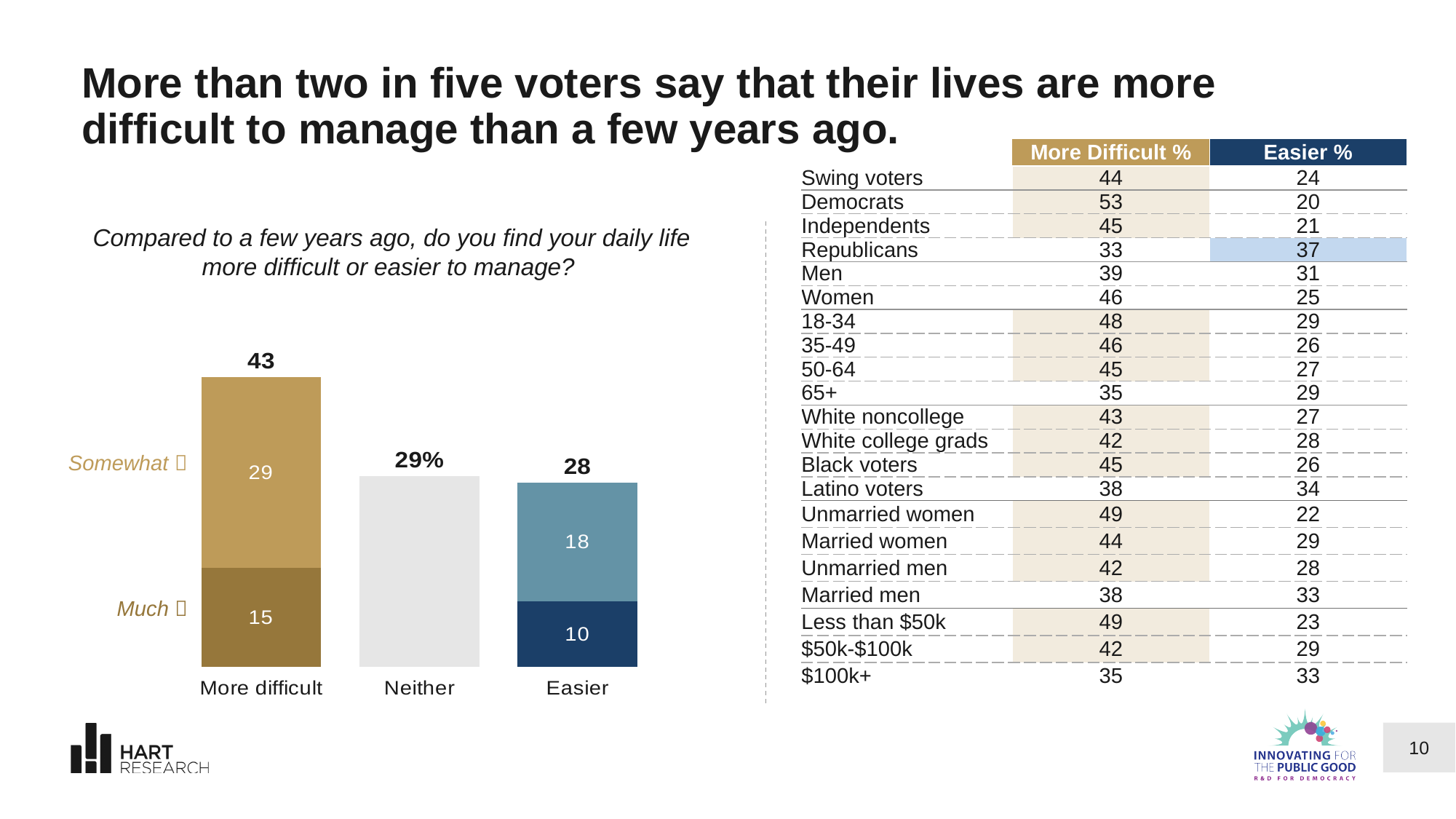
What is the difference between the 'More difficult' total and the 'Easier' total? 15 Which is larger, the 'Somewhat' segment of the 'More difficult' bar or the top segment of the 'Easier' bar? Somewhat segment of More difficult How many categories are shown on the x axis of the bar chart? 3 What is the total value shown above the 'More difficult' bar? 43 What is the value of the bottom (darker) segment of the 'Easier' bar? 10 What is the value shown for the 'Neither' bar? 29% What is the 'Somewhat' segment value in the 'More difficult' bar? 29 Which category has the lowest total in the bar chart? Easier What is the 'Much' segment value in the 'More difficult' bar? 15 What is the total value shown above the 'Easier' bar? 28 Which category has the highest total in the bar chart? More difficult What type of chart is shown on the slide? bar chart